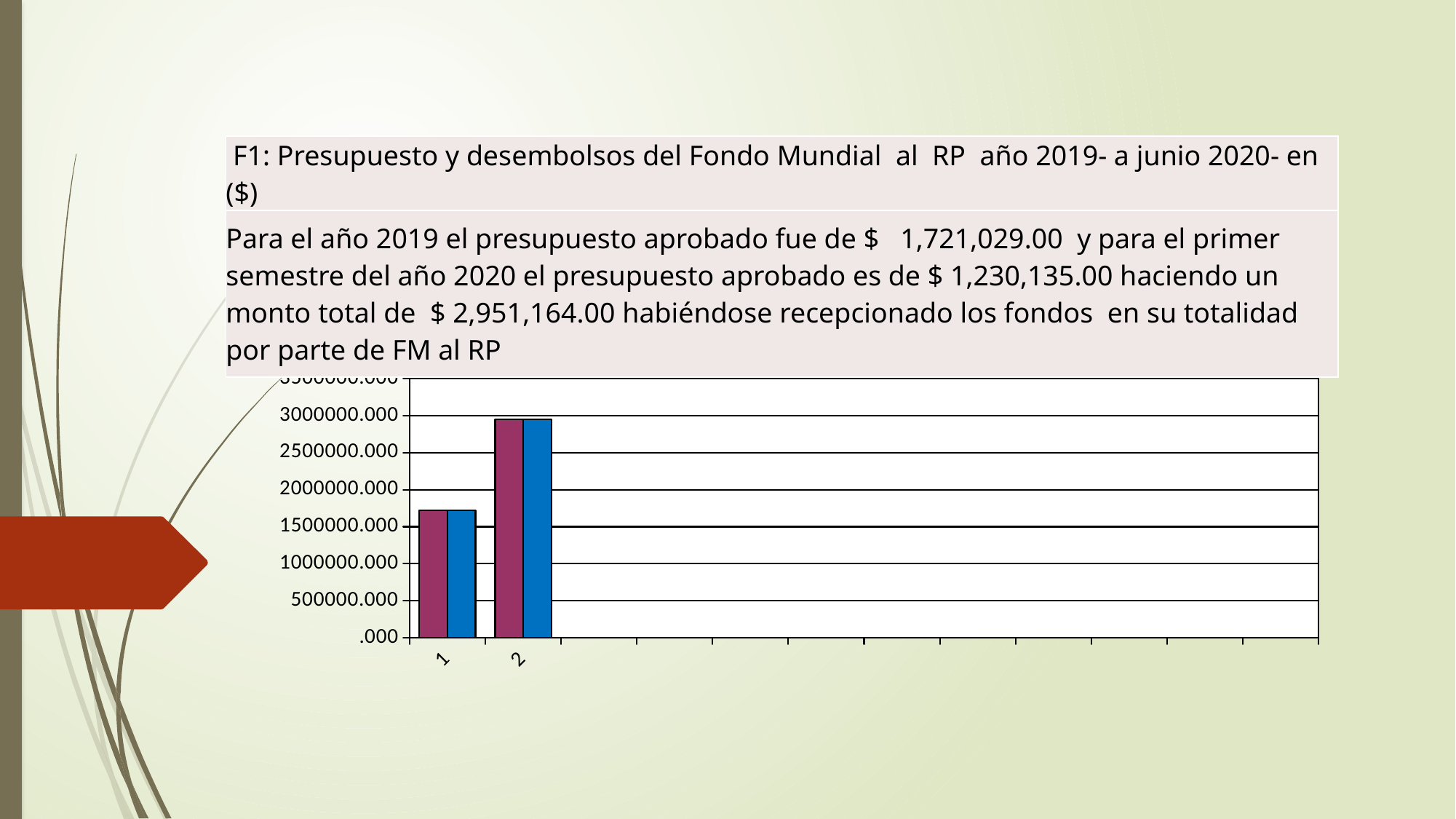
How many bars are drawn for each category in the chart? 2 Are the bars for category 1 greater or less than 2000000.000? less Are the bars for category 1 greater or less than 1500000.000? greater What kind of chart is shown on the slide? bar chart Are the bars for category 2 greater or less than 2500000.000? greater Which category has the tallest bars in the chart? 2 Do the values rise or fall from category 1 to category 2? rise Which category has larger values, 1 or 2? 2 How many categories are shown on the x axis of the chart? 2 What is the lowest tick label shown on the y axis of the chart? .000 Which category has the shortest bars in the chart? 1